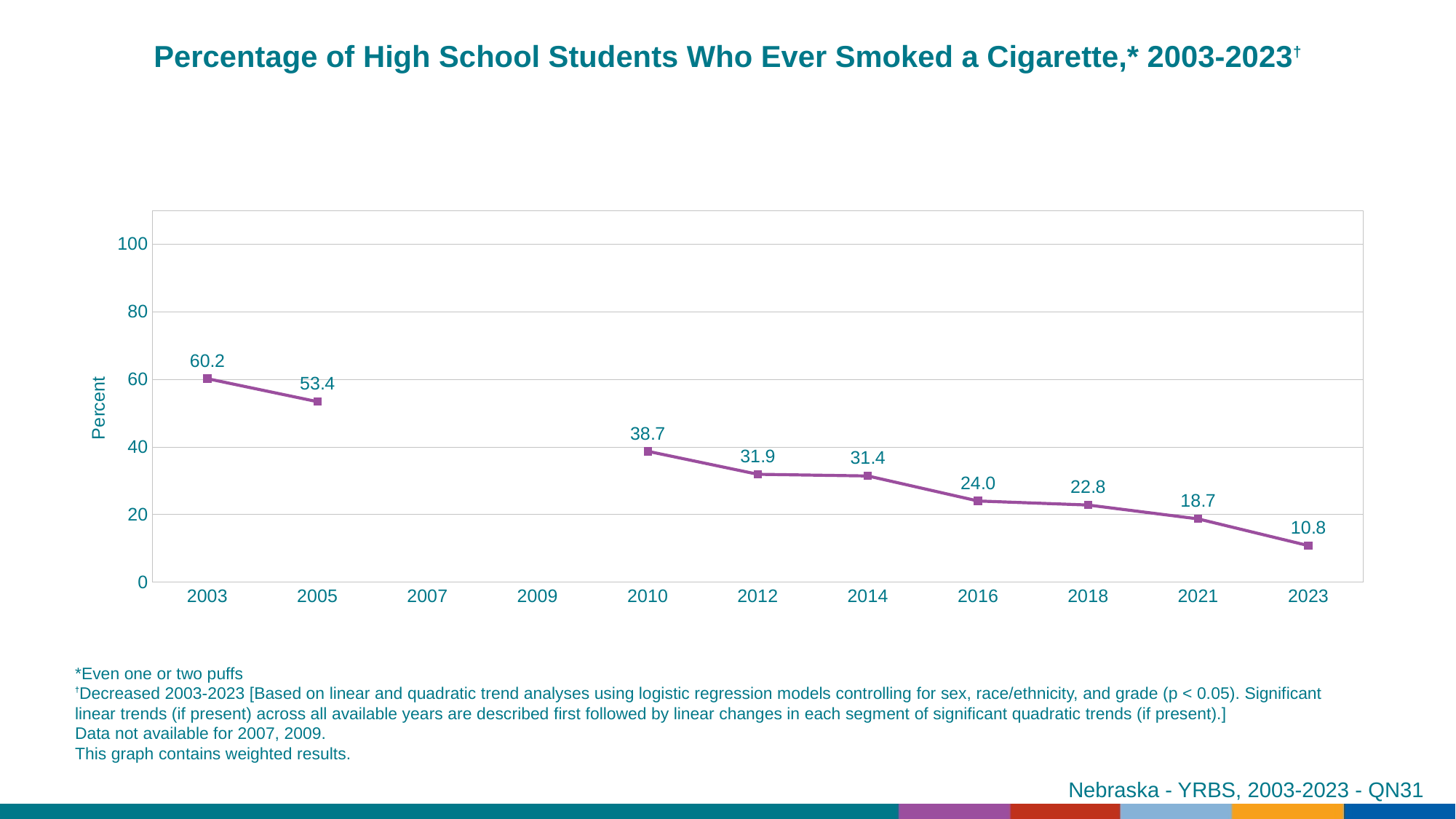
What kind of chart is shown on the slide? Line chart Which year has the highest value on the chart? 2003 What is the difference between the 2010 value and the 2012 value? 6.8 Do the values rise or fall from 2003 to 2023? Fall Which year has a larger value, 2016 or 2021? 2016 What percentage of high school students had ever smoked a cigarette in 2003? 60.2 What is the value plotted for 2023? 10.8 What is the value plotted for 2014? 31.4 What is the difference between the 2003 value and the 2023 value? 49.4 For which years is data not available according to the slide? 2007, 2009 Which year has the lowest value on the chart? 2023 How many data points are plotted on the chart? 9